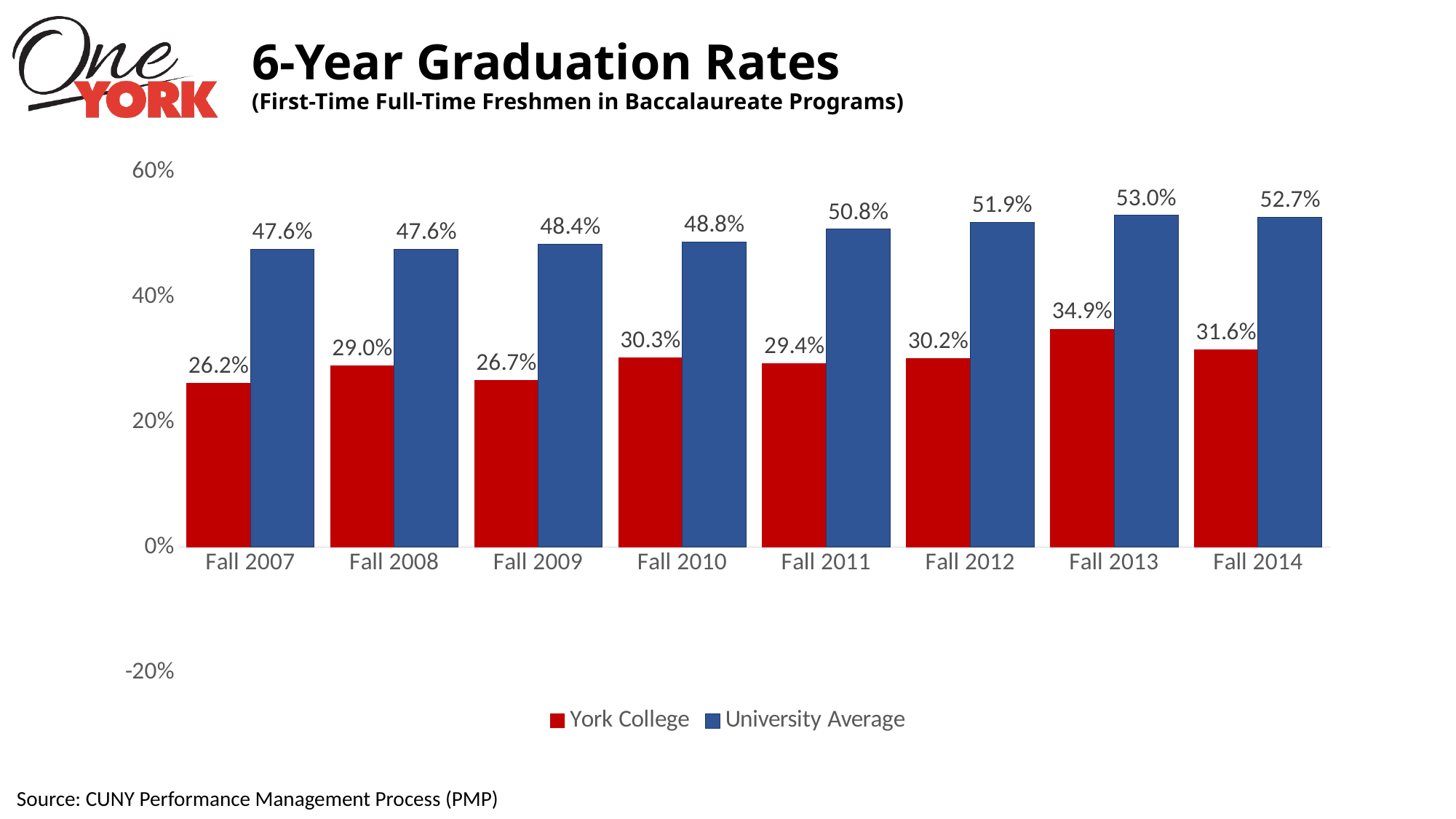
Is the York College graduation rate for Fall 2013 greater or less than 40%? less In which cohort year is the York College graduation rate lowest? Fall 2007 Which is larger for Fall 2011: the York College rate or the University Average rate? University Average How many cohort years are shown on the x axis? 8 What is the University Average 6-year graduation rate for Fall 2012? 51.9% What is the York College 6-year graduation rate for Fall 2010? 30.3% Which colour represents York College in the chart? Red In which cohort year is the University Average graduation rate highest? Fall 2013 What is the difference between the University Average and York College graduation rates for Fall 2014? 21.1% How many series does the legend list? 2 In which cohort year is the York College graduation rate highest? Fall 2013 What kind of chart is shown on the slide? Bar chart